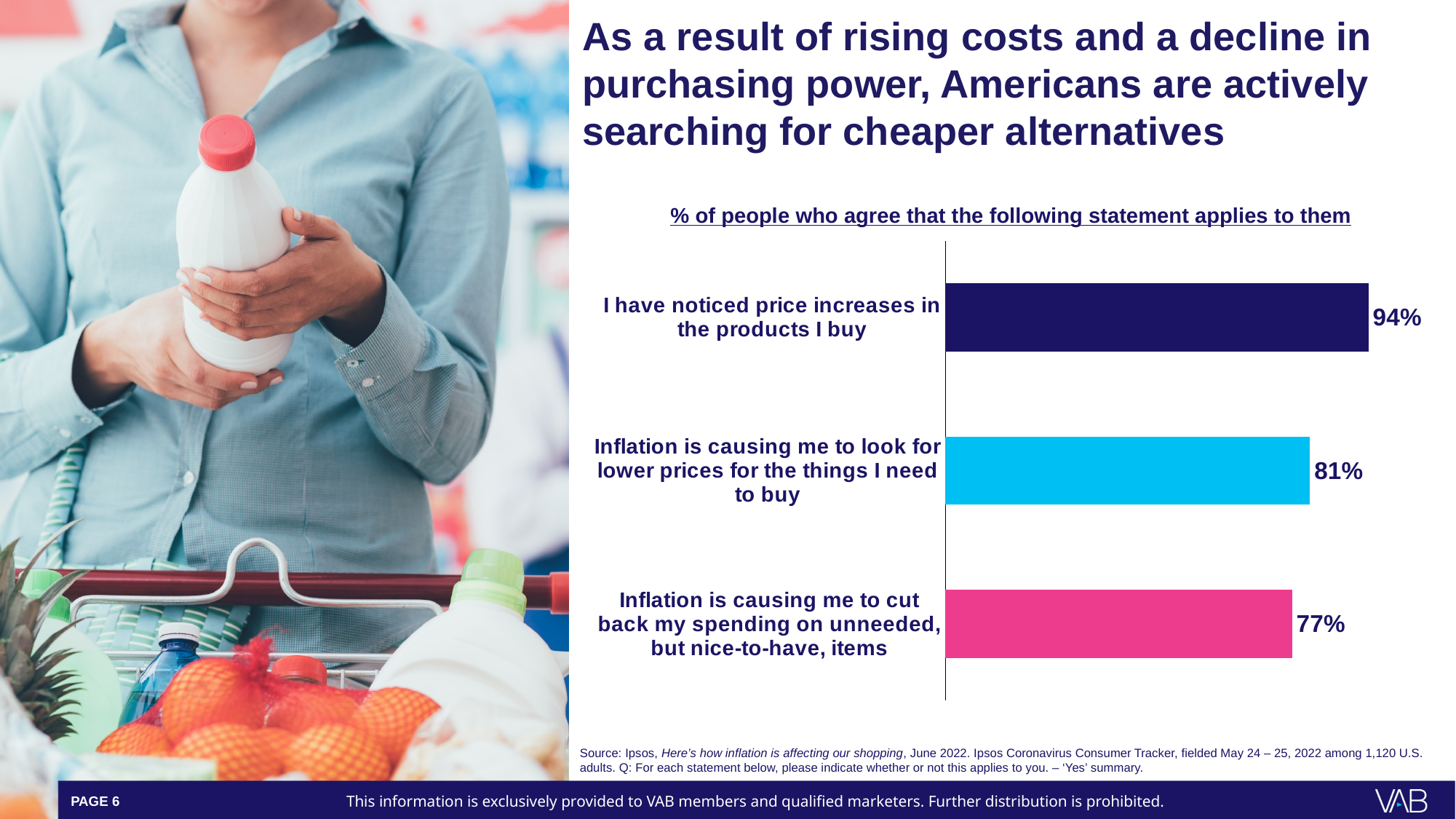
What colour is the bar for "Inflation is causing me to cut back my spending on unneeded, but nice-to-have, items"? Pink What type of chart is used on the slide? Bar chart Which statement has the highest percentage of people agreeing with it? I have noticed price increases in the products I buy What is the difference in percentage points between the statement about looking for lower prices and the statement about cutting back spending on nice-to-have items? 4 percentage points How many statements are shown in the chart? 3 Which has a higher share of agreement: noticing price increases in products bought, or cutting back spending on nice-to-have items? I have noticed price increases in the products I buy What percentage of people agree that inflation is causing them to look for lower prices for the things they need to buy? 81% Which statement has the lowest percentage of people agreeing with it? Inflation is causing me to cut back my spending on unneeded, but nice-to-have, items What is the difference in percentage points between "I have noticed price increases in the products I buy" and "Inflation is causing me to look for lower prices for the things I need to buy"? 13 percentage points What percentage of people agree with the statement "I have noticed price increases in the products I buy"? 94% What percentage of people agree that inflation is causing them to cut back spending on unneeded, but nice-to-have, items? 77% What is the title of the chart? % of people who agree that the following statement applies to them